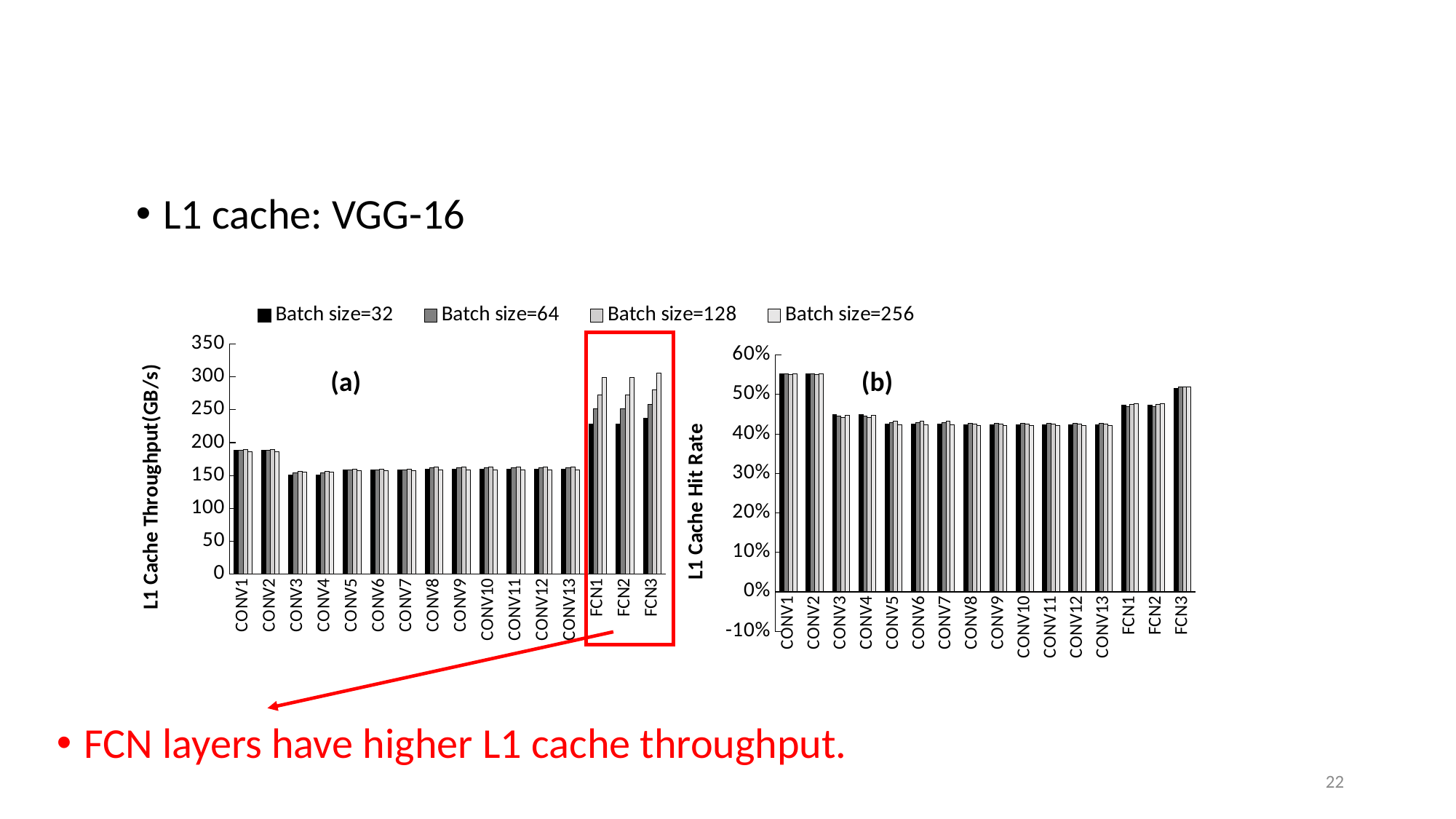
In chart (b), L1 Cache Hit Rate, which is larger at Batch size=32: FCN3 or FCN1? FCN3 How many series does the legend list? 4 In chart (b), L1 Cache Hit Rate, which is larger at Batch size=128: CONV2 or CONV8? CONV2 In chart (a), L1 Cache Throughput, is the value for CONV1 at Batch size=32 greater or less than 150? greater In chart (a), L1 Cache Throughput, is the value for CONV7 at Batch size=64 greater or less than 200? less How many layer categories are shown on the x axis of chart (b), L1 Cache Hit Rate? 16 What kind of chart is chart (a), L1 Cache Throughput? bar chart In chart (b), L1 Cache Hit Rate, is the value for CONV1 at Batch size=32 greater or less than 50%? greater What is the y-axis title of chart (a)? L1 Cache Throughput(GB/s) In chart (a), L1 Cache Throughput, which is larger at Batch size=256: FCN2 or CONV2? FCN2